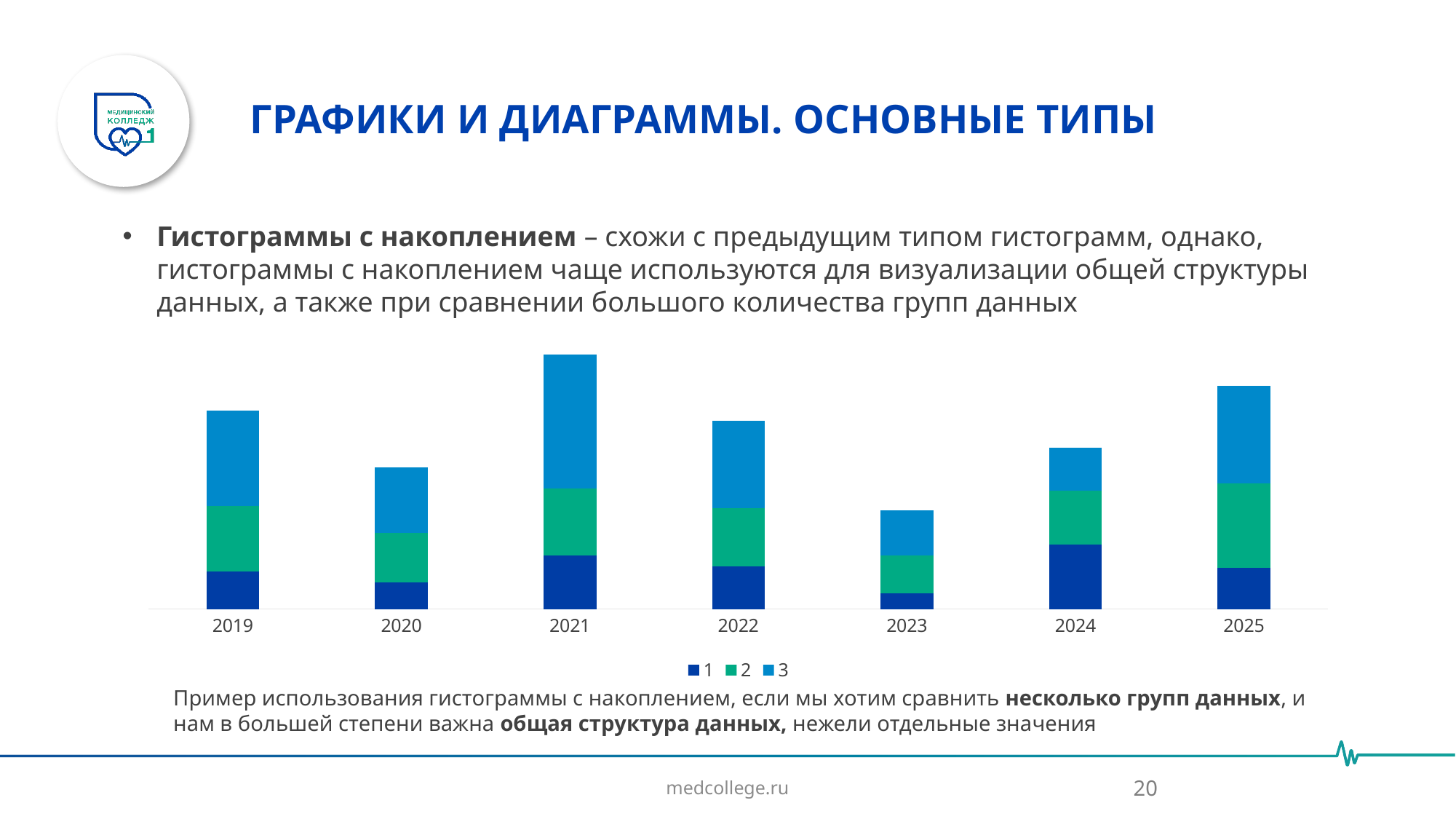
What is the first year shown on the x axis of the chart? 2019 What kind of chart is shown on the slide? Stacked bar chart Which year has the shortest stacked bar in the chart? 2023 Which year has the tallest stacked bar in the chart? 2021 Do the total bar heights rise steadily from 2019 to 2025? No Which year has the larger segment for series 1, 2023 or 2024? 2024 Which stacked bar is taller, 2019 or 2020? 2019 How many series does the chart's legend list? 3 Which stacked bar is taller, 2024 or 2025? 2025 What are the entries listed in the chart's legend? 1, 2, 3 How many categories (years) are shown on the x axis of the chart? 7